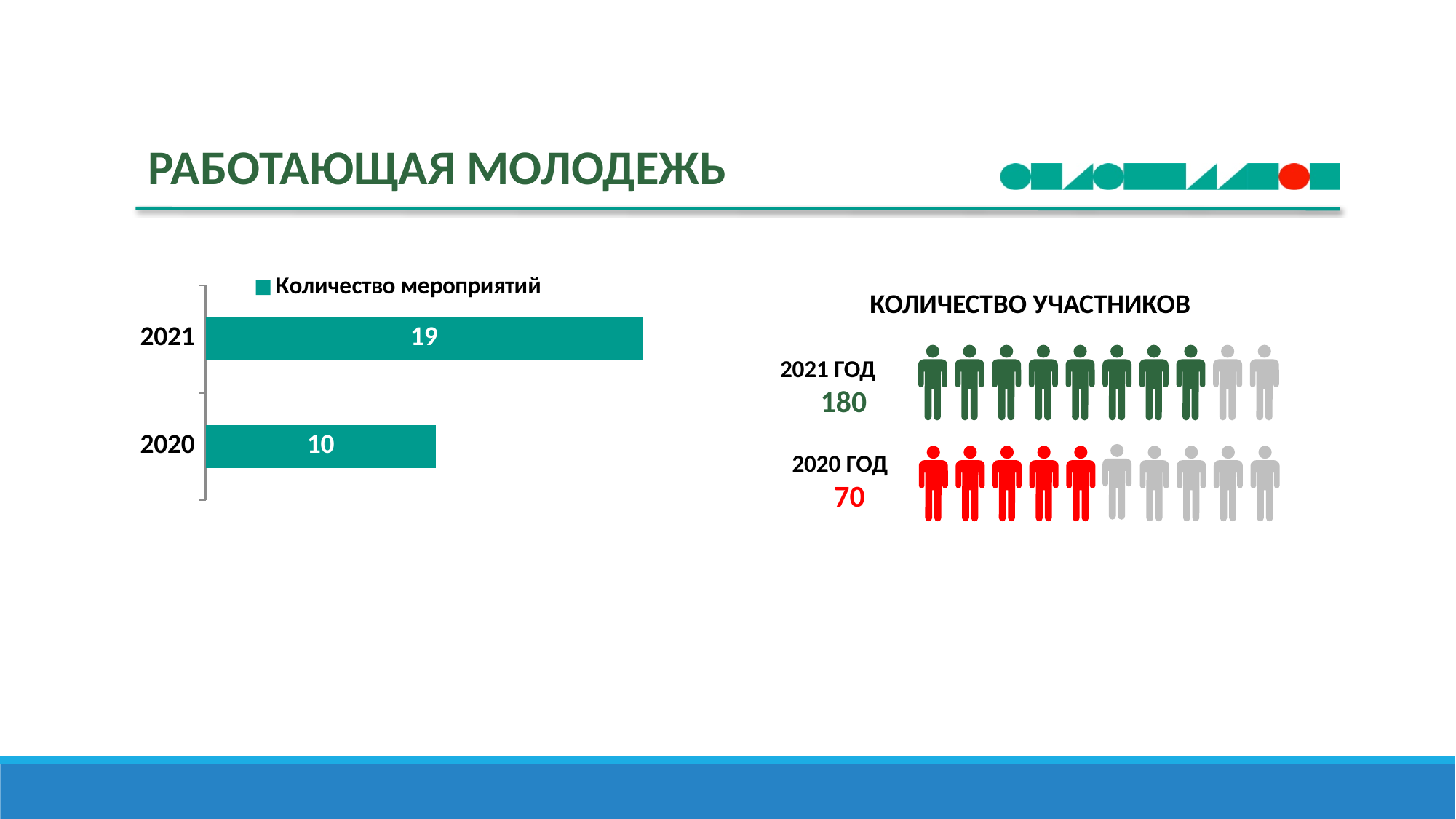
How many series does the legend of the bar chart on the left list? 1 In the 'КОЛИЧЕСТВО УЧАСТНИКОВ' graphic on the right, what is the difference between the values for 2021 ГОД and 2020 ГОД? 110 In the bar chart on the left, which year has the highest value? 2021 What kind of chart is shown on the left of the slide? bar chart How many categories does the bar chart on the left show? 2 What series name is shown in the legend of the bar chart on the left? Количество мероприятий In the bar chart on the left, what is the difference between the values for 2021 and 2020? 9 In the 'КОЛИЧЕСТВО УЧАСТНИКОВ' graphic on the right, what is the value for 2021 ГОД? 180 In the bar chart on the left, which year has the lowest value? 2020 In the bar chart on the left, which is larger: the value for 2021 or the value for 2020? 2021 In the bar chart on the left, what is the value for 2020? 10 In the bar chart on the left, what is the value for 2021? 19